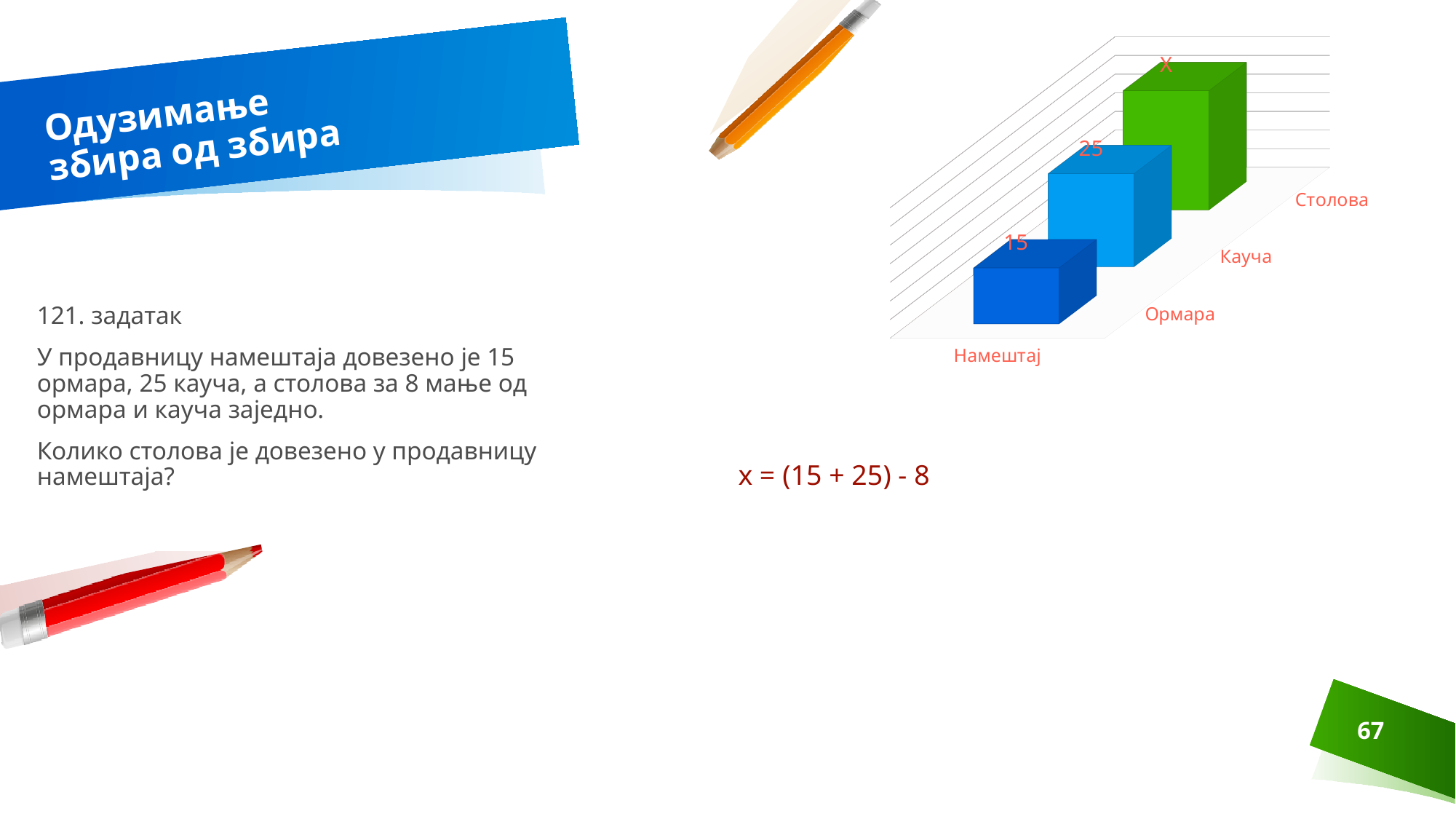
What is the axis label printed below the categories in the chart? Намештај Which category has the shortest bar in the chart? Ормара Do the bars rise or fall from Ормара to Столова in the chart? rise What colour is the Столова bar in the chart? green Which category has the tallest bar in the chart? Столова Which is larger in the chart, the value for Кауча or the value for Ормара? Кауча What value is shown for Кауча in the chart? 25 What label is printed above the Столова bar in the chart? x How many categories are plotted in the chart? 3 What value is shown for Ормара in the chart? 15 What kind of chart is shown on the slide? bar chart What is the difference between the values for Кауча and Ормара in the chart? 10